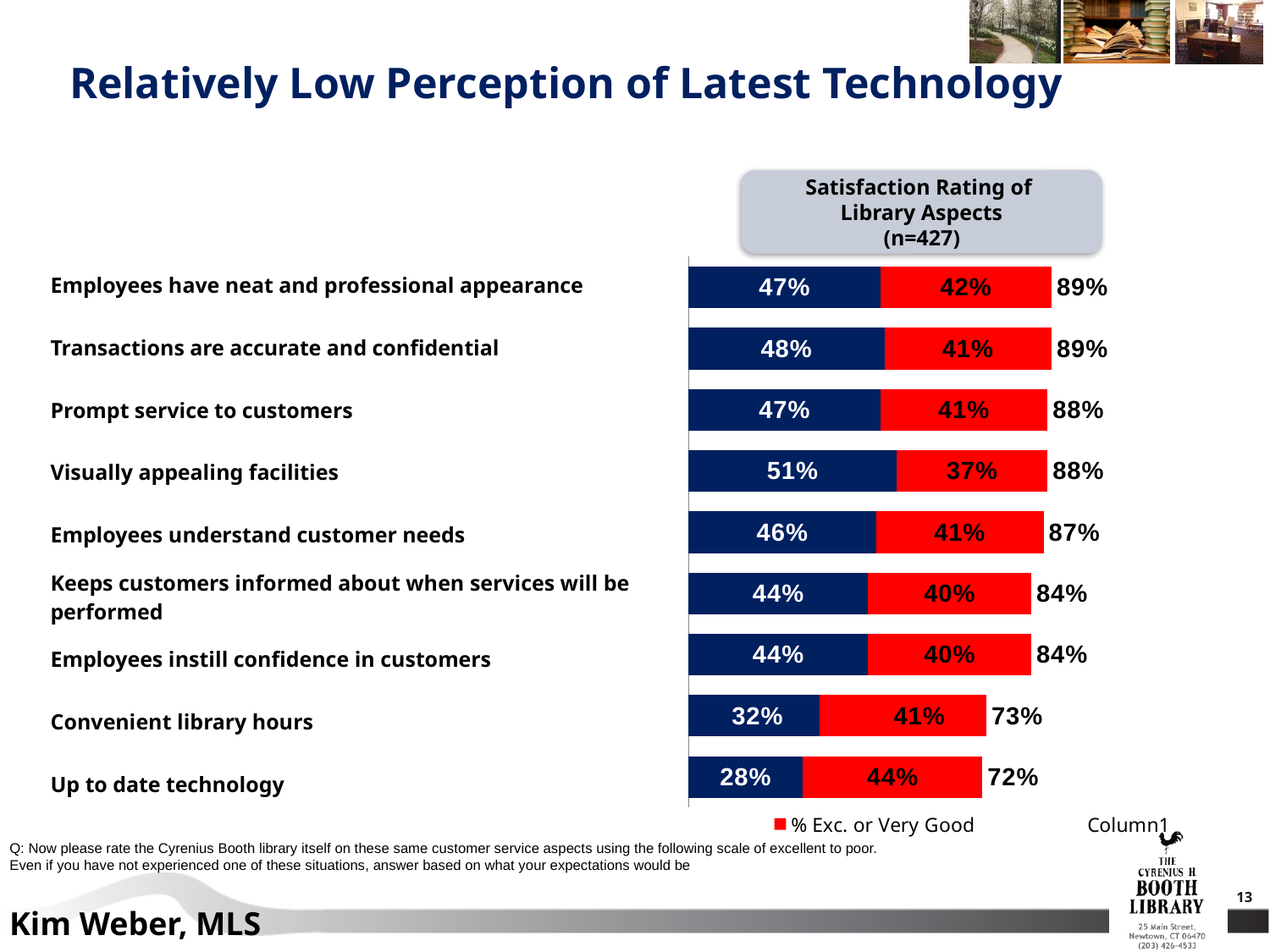
Which library aspect has the highest value in the blue segment? Visually appealing facilities How many library aspects (categories) are plotted in the chart? 9 What is the difference between the total for "Employees understand customer needs" and the total for "Convenient library hours"? 14 percentage points Which has the larger blue segment: "Convenient library hours" or "Up to date technology"? Convenient library hours What is the value of the red segment for "Convenient library hours"? 41% Which library aspect has the lowest total percentage? Up to date technology Which library aspect has the lowest value in the blue segment? Up to date technology What is the total of the stacked bar for "Prompt service to customers"? 88% What kind of chart is shown on the slide? Stacked bar chart What sample size (n) is stated in the chart title? n=427 What is the total percentage shown for "Up to date technology"? 72% What is the value of the blue segment for "Visually appealing facilities"? 51%